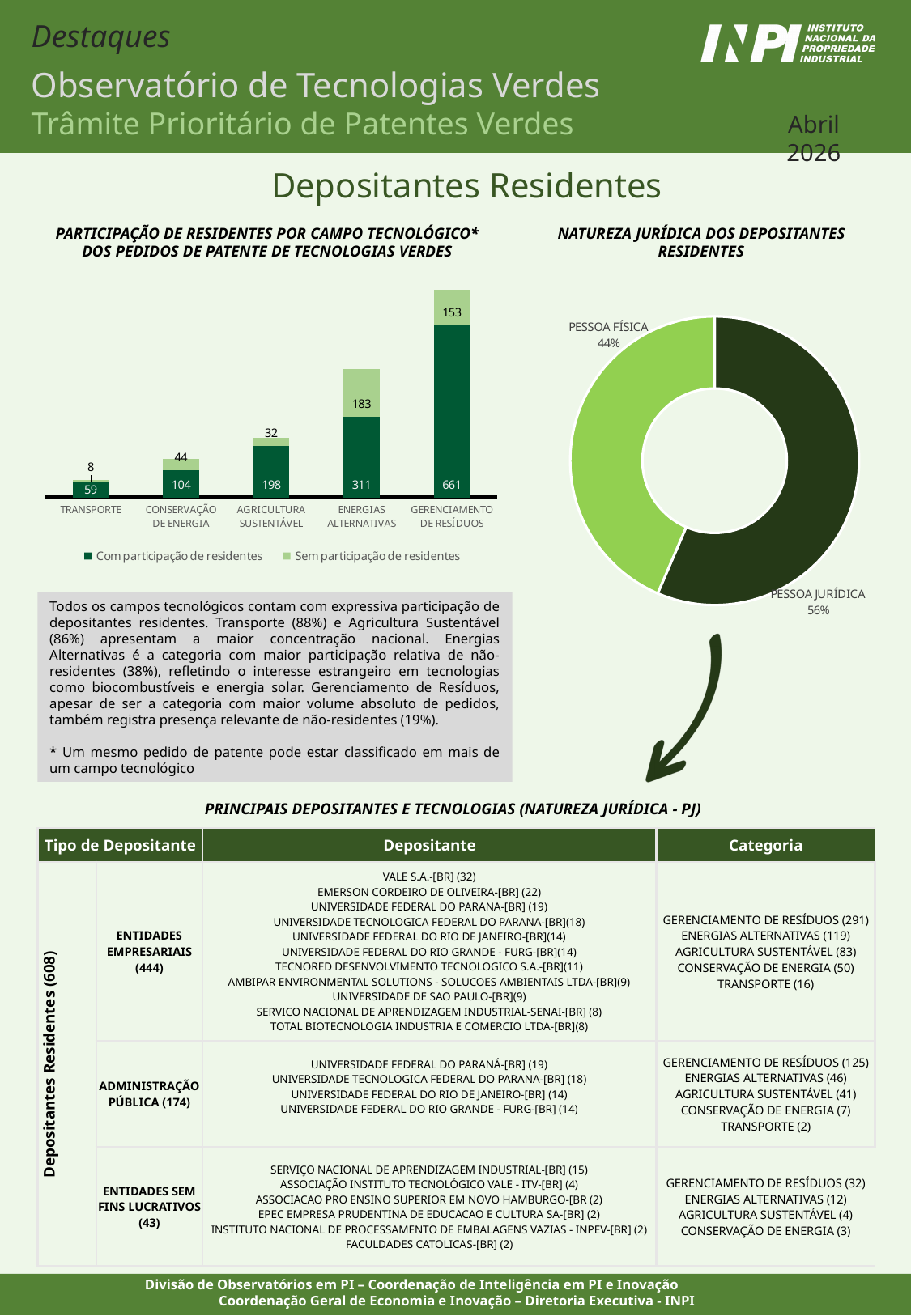
In the bar chart 'Participação de residentes por campo tecnológico', how many categories are shown on the x axis? 5 In the chart 'Natureza Jurídica dos Depositantes Residentes', which is larger, Pessoa Física or Pessoa Jurídica? Pessoa Jurídica In the bar chart 'Participação de residentes por campo tecnológico', which category has the lowest value for 'Sem participação de residentes'? Transporte In the bar chart 'Participação de residentes por campo tecnológico', what is the total of the stacked bar for Conservação de Energia? 148 In the bar chart 'Participação de residentes por campo tecnológico', what is the difference between the 'Com participação de residentes' values for Energias Alternativas and Agricultura Sustentável? 113 In the chart 'Natureza Jurídica dos Depositantes Residentes', what share is Pessoa Jurídica? 56% In the bar chart 'Participação de residentes por campo tecnológico', what is the value for 'Sem participação de residentes' in Energias Alternativas? 183 In the bar chart 'Participação de residentes por campo tecnológico', how many series does the legend list? 2 In the bar chart 'Participação de residentes por campo tecnológico', which category has the highest value for 'Com participação de residentes'? Gerenciamento de Resíduos What kind of chart is 'Natureza Jurídica dos Depositantes Residentes'? Donut (pie) chart In the bar chart 'Participação de residentes por campo tecnológico', what is the value for 'Com participação de residentes' in Gerenciamento de Resíduos? 661 In the bar chart 'Participação de residentes por campo tecnológico', what is the value for 'Com participação de residentes' in Transporte? 59